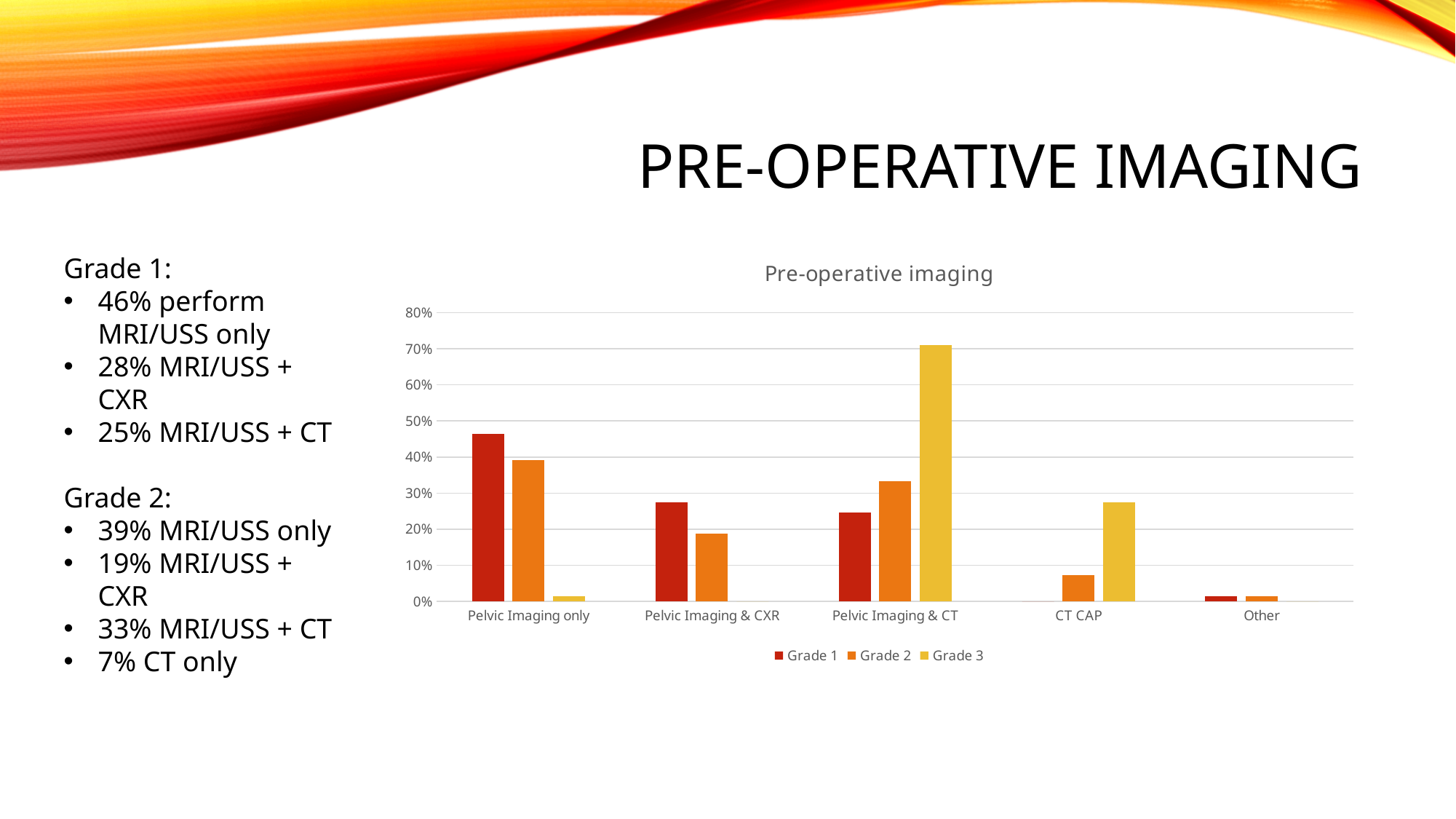
What kind of chart is shown on the slide? bar chart Is the Grade 2 value for CT CAP greater or less than 10%? less For Grade 1, which category has the highest bar? Pelvic Imaging only For Pelvic Imaging & CT, which is larger: Grade 2 or Grade 3? Grade 3 For Grade 3, which category has the highest bar? Pelvic Imaging & CT For Pelvic Imaging & CXR, which is larger: Grade 1 or Grade 2? Grade 1 What is the title of the chart? Pre-operative imaging Is the Grade 1 value for Pelvic Imaging only greater or less than 40%? greater Is the Grade 3 value for Pelvic Imaging & CT greater or less than 60%? greater How many series does the chart legend list? 3 How many imaging categories are shown on the x axis of the chart? 5